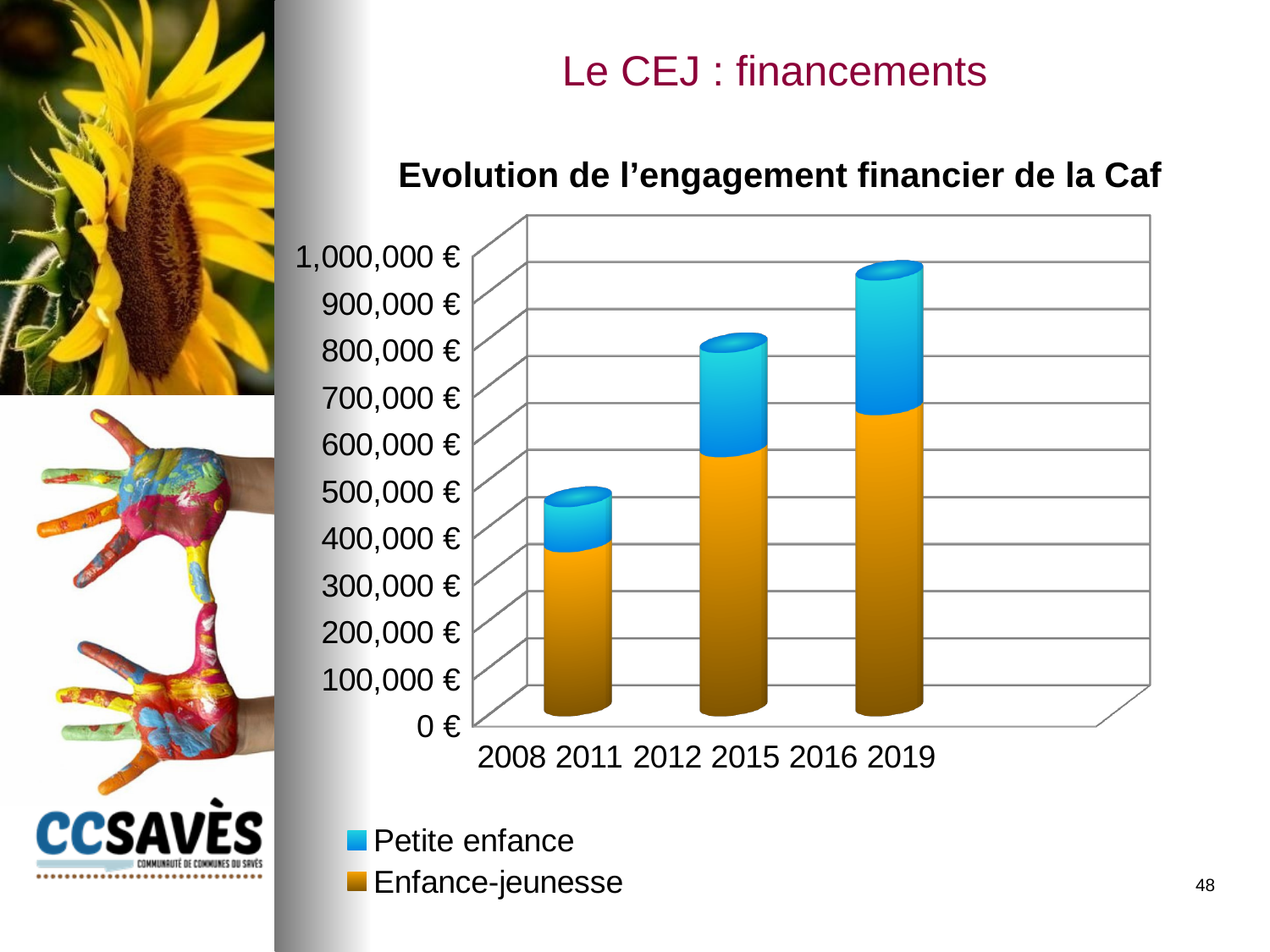
Do the total bars rise or fall from 2008 2011 to 2016 2019? rise Which period has the highest total bar? 2016 2019 Is the total bar for 2008 2011 greater or less than 600,000 €? less Is the total bar for 2016 2019 greater or less than 800,000 €? greater How many series does the legend list? 2 Which series is shown in blue in the legend? Petite enfance Which period has the lowest total bar? 2008 2011 Which is larger, the total bar for 2012 2015 or the total bar for 2008 2011? 2012 2015 What kind of chart is shown on the slide? stacked bar chart What is the title of the chart? Evolution de l'engagement financier de la Caf How many bars (periods) are plotted on the chart? 3 Is the Enfance-jeunesse value for 2016 2019 greater or less than 600,000 €? greater